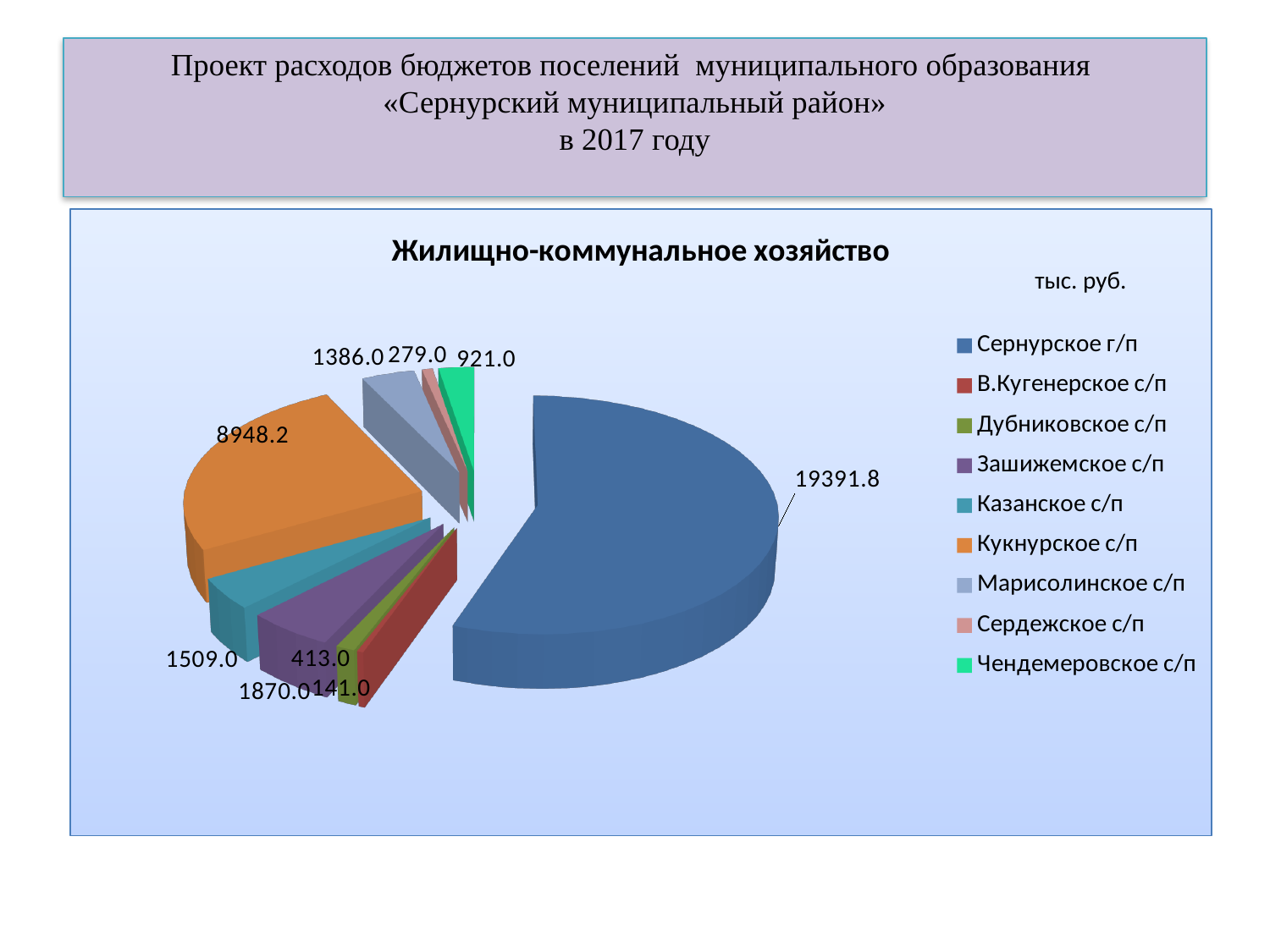
Which category has the smallest slice? В.Кугенерское с/п Which category has the largest slice? Сернурское г/п Which is larger, the value for Зашижемское с/п or Казанское с/п? Зашижемское с/п What kind of chart is shown on the slide? pie chart What is the value for Чендемеровское с/п? 921.0 How many categories does the legend list? 9 What is the value for Сердежское с/п? 279.0 What is the title of the chart? Жилищно-коммунальное хозяйство What is the value for Кукнурское с/п? 8948.2 What is the value for Сернурское г/п? 19391.8 What is the difference between the values for Сернурское г/п and Кукнурское с/п? 10443.6 What is the value for Марисолинское с/п? 1386.0